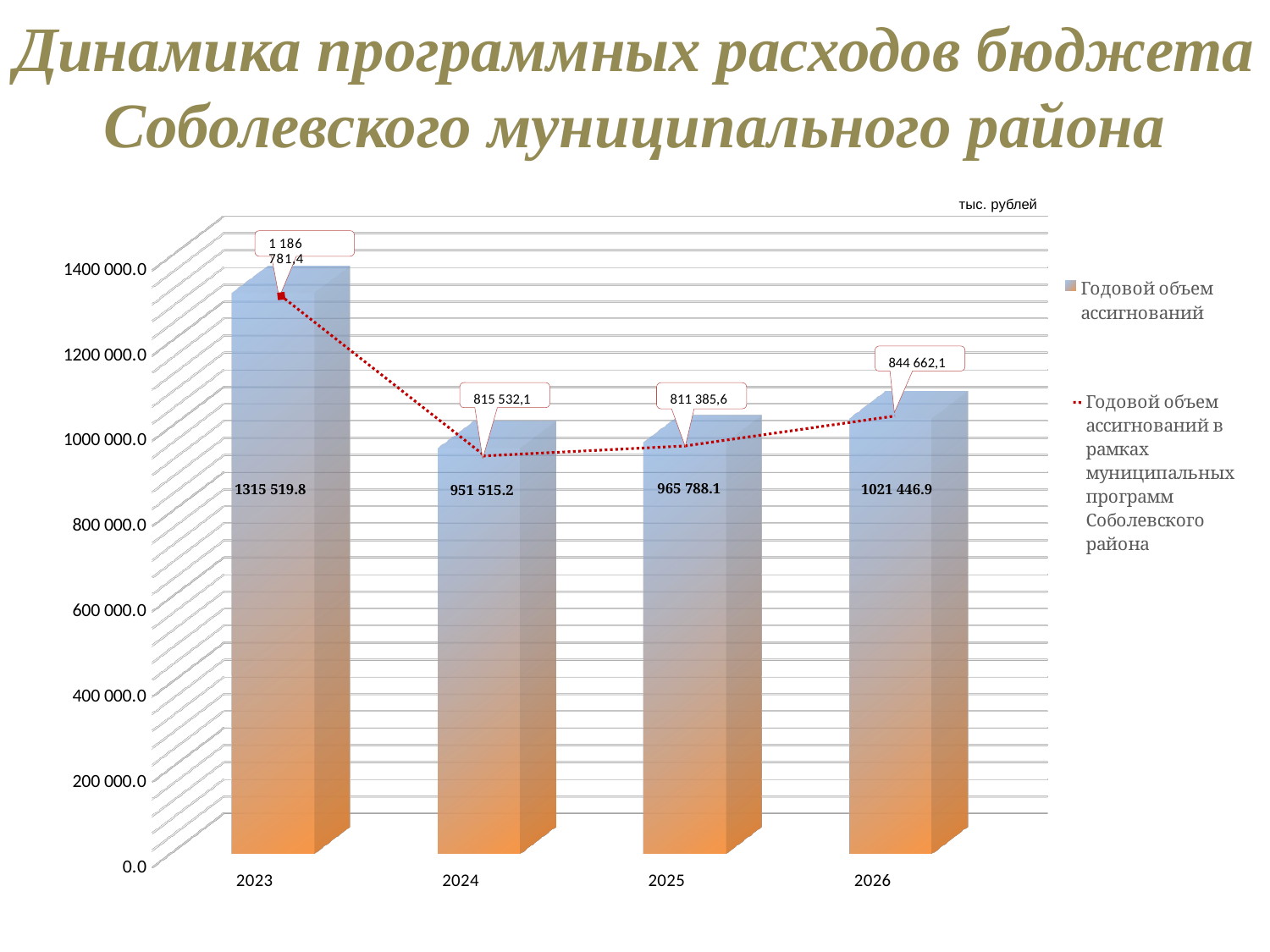
What is the value of the 'Годовой объем ассигнований' bar for 2023? 1315 519.8 What is the difference between the 'Годовой объем ассигнований' bars for 2023 and 2024? 364 004.6 Which year has the highest 'Годовой объем ассигнований' bar? 2023 Which year has the lowest value on the dotted line series? 2025 What is the value of the dotted line series for 2026? 844 662,1 How many years are shown on the x axis? 4 What is the value of the 'Годовой объем ассигнований' bar for 2026? 1021 446.9 What is the value of the dotted line series (Годовой объем ассигнований в рамках муниципальных программ) for 2024? 815 532,1 How many series does the legend list? 2 Is the 'Годовой объем ассигнований' bar for 2023 greater or less than 1200 000.0? greater Which year has the lowest 'Годовой объем ассигнований' bar? 2024 Which is larger: the 'Годовой объем ассигнований' bar for 2024 or for 2025? 2025